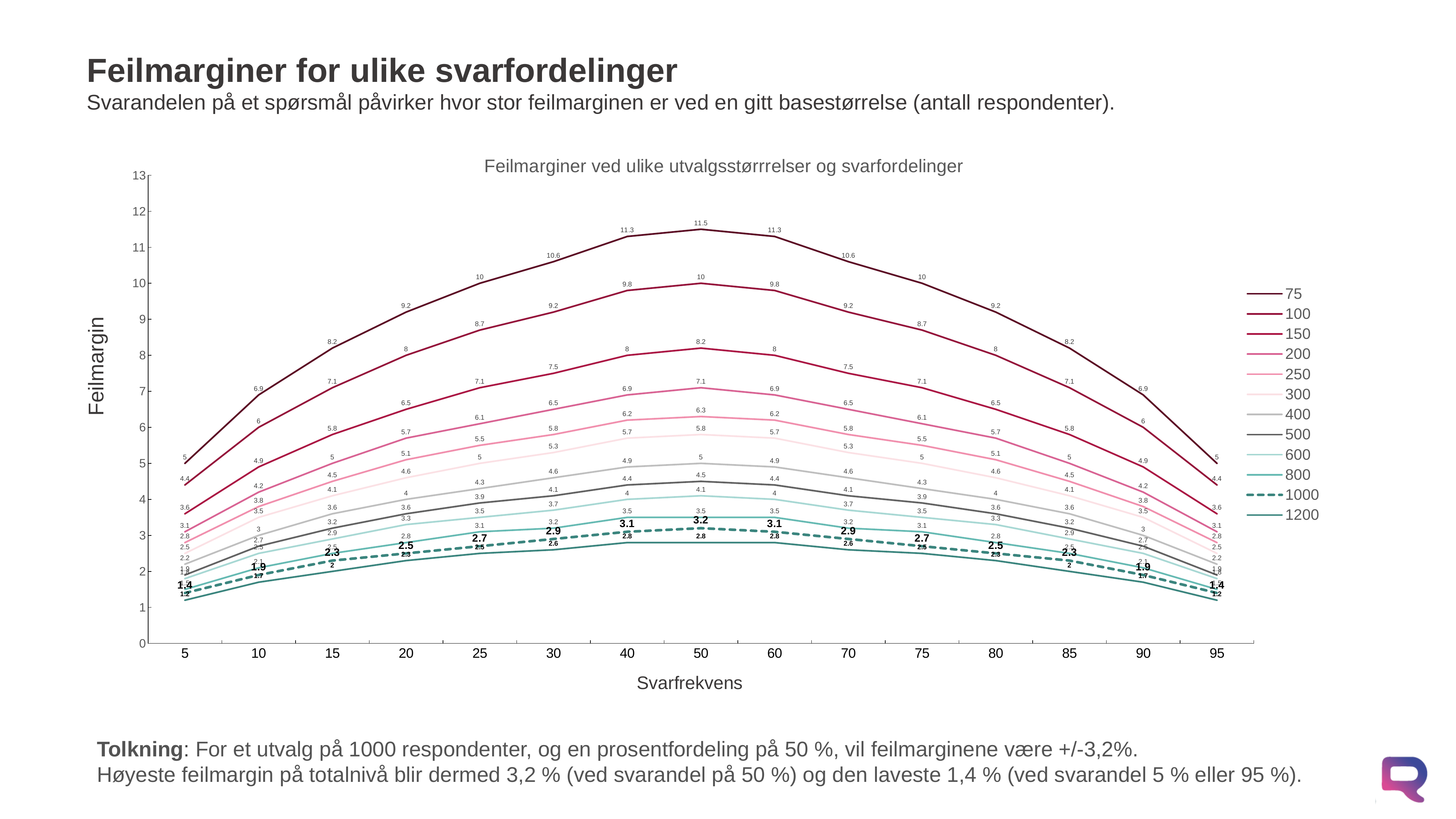
What is the value of the 75 series at a svarfrekvens of 50? 11.5 What is the value of the 1000 series at a svarfrekvens of 5? 1.4 Which series has the highest value at a svarfrekvens of 50? 75 How does the 75 series change as svarfrekvens goes from 5 to 50? rises What type of chart is shown on the slide? line chart What is the value of the 1000 series at a svarfrekvens of 50? 3.2 How many series does the legend list? 12 What is the value of the 100 series at a svarfrekvens of 50? 10 Which is larger at a svarfrekvens of 50: the 150 series or the 200 series? 150 What is the difference between the 75 series and the 100 series at a svarfrekvens of 50? 1.5 Which series has the lowest value at a svarfrekvens of 50? 1200 What is the chart's title? Feilmarginer ved ulike utvalgsstørrrelser og svarfordelinger